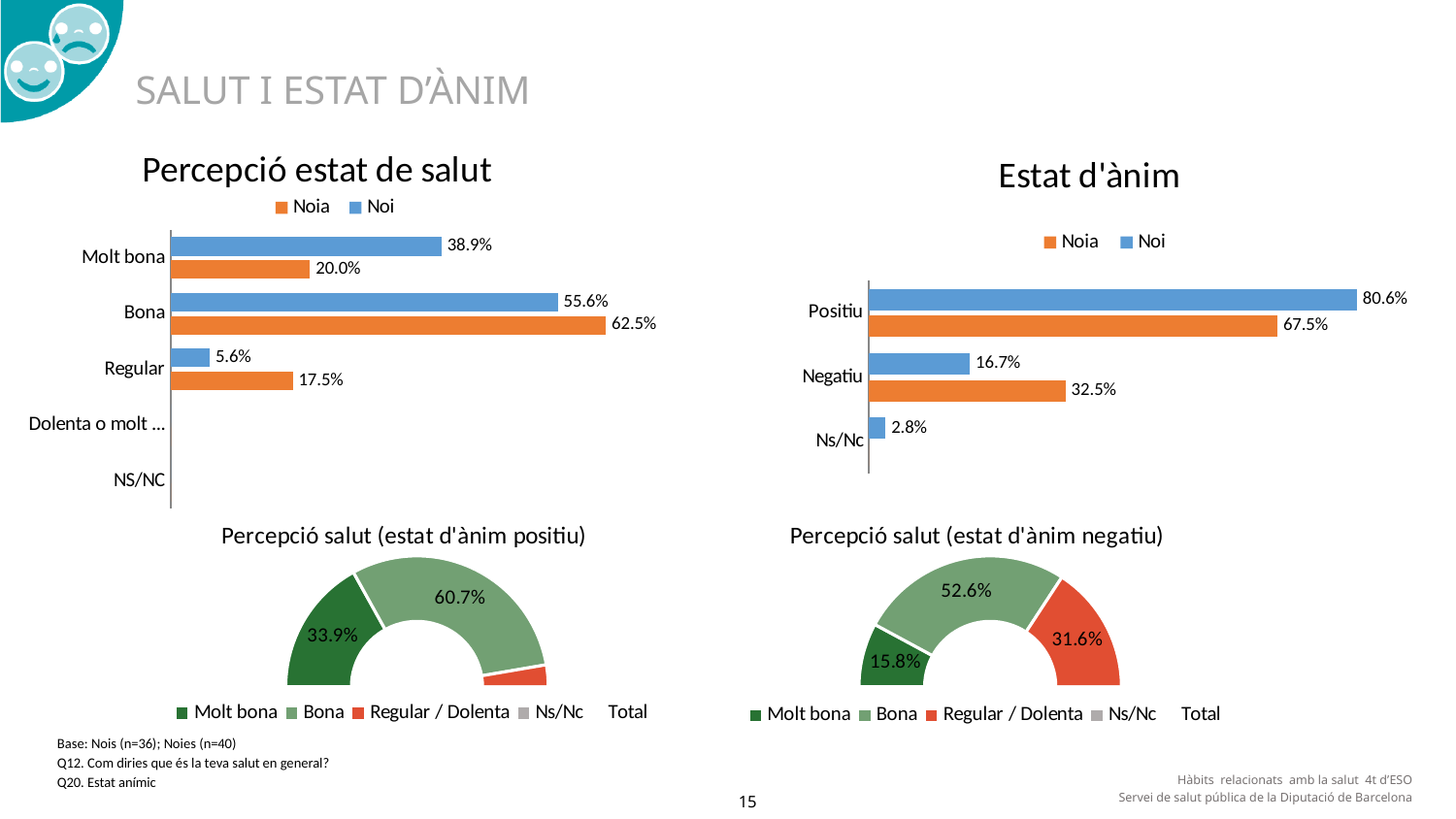
In the 'Estat d'ànim' chart, what is the value for Noia in the 'Negatiu' category? 32.5% In the 'Percepció estat de salut' chart, what is the difference between the Noia and Noi values for 'Bona'? 6.9 percentage points In the 'Percepció estat de salut' chart, what is the value for Noia in the 'Regular' category? 17.5% In the 'Estat d'ànim' chart, what is the difference between the Noi and Noia values for 'Positiu'? 13.1 percentage points In the 'Percepció salut (estat d'ànim positiu)' chart, which category has the largest share? Bona In the 'Percepció estat de salut' chart, what is the value for Noi in the 'Molt bona' category? 38.9% In the 'Percepció estat de salut' chart, which is larger for 'Molt bona', Noi or Noia? Noi In the 'Percepció estat de salut' chart, how many categories are listed on the vertical axis? 5 How many series does the legend of the 'Estat d'ànim' chart list? 2 In the 'Estat d'ànim' chart, what is the value for Noi in the 'Positiu' category? 80.6% What kind of chart is the 'Estat d'ànim' chart? Bar chart In the 'Percepció salut (estat d'ànim negatiu)' chart, what share does 'Regular / Dolenta' have? 31.6%